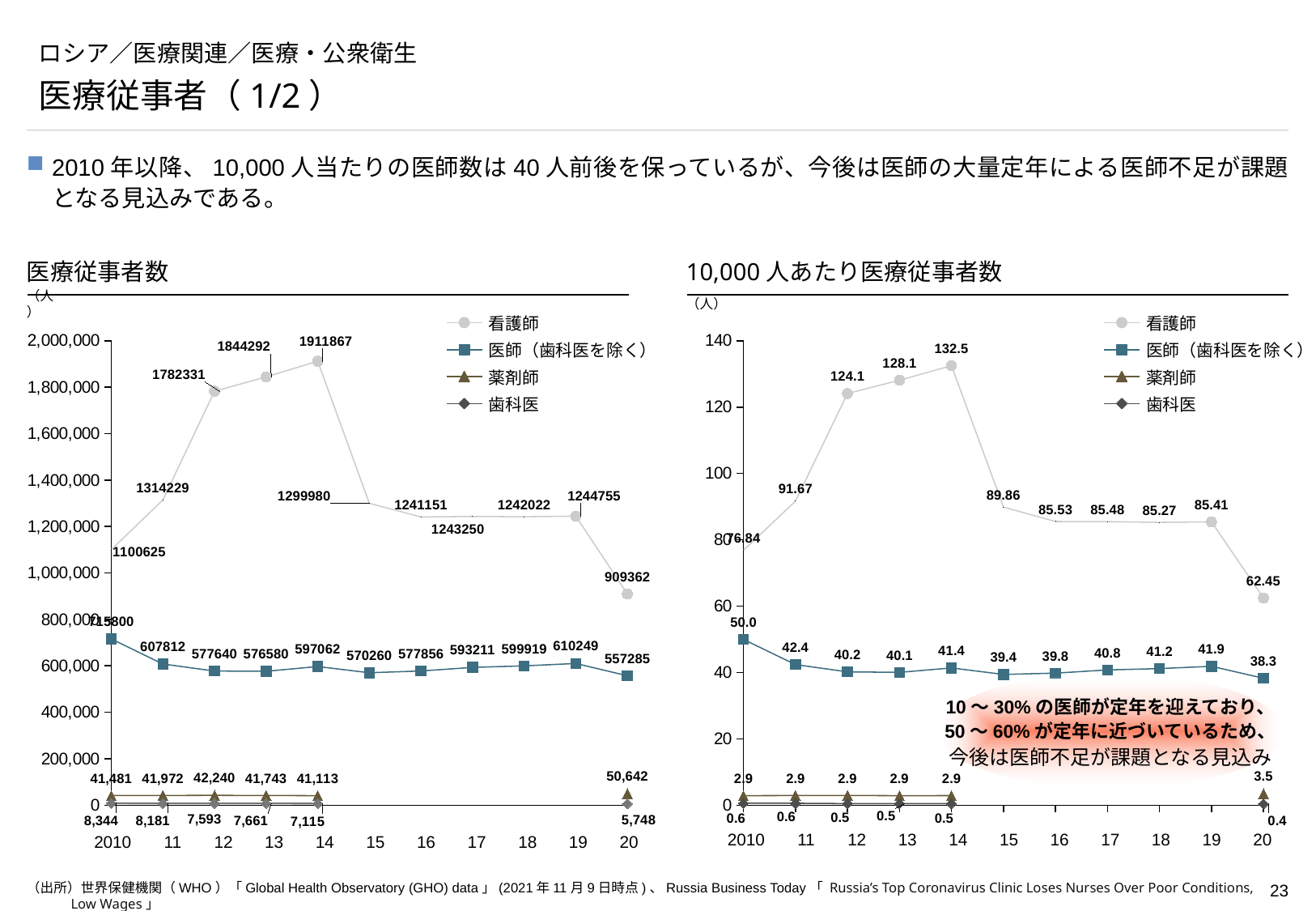
In the chart titled 10,000人あたり医療従事者数, in which year is the 医師（歯科医を除く） series at its lowest? 2020 In the chart titled 医療従事者数, what is the value for 医師（歯科医を除く） in 2020? 557285 In the chart titled 医療従事者数, in which year is the 看護師 series at its highest? 2014 In the chart titled 10,000人あたり医療従事者数, what is the difference between the 医師（歯科医を除く） values for 2010 and 2020? 11.7 In the chart titled 医療従事者数, what is the value for 看護師 in 2014? 1911867 How many series does the legend of the chart titled 10,000人あたり医療従事者数 list? 4 In the chart titled 医療従事者数, what is the value for 歯科医 in 2020? 5,748 What kind of chart is the chart titled 10,000人あたり医療従事者数? Line chart In the chart titled 医療従事者数, what is the difference between the 薬剤師 values for 2020 and 2010? 9,161 In the chart titled 10,000人あたり医療従事者数, which is larger, the 看護師 value in 2015 or in 2016? 2015 How many years are plotted on the x axis of the chart titled 医療従事者数? 11 In the chart titled 10,000人あたり医療従事者数, what is the value for 看護師 in 2014? 132.5